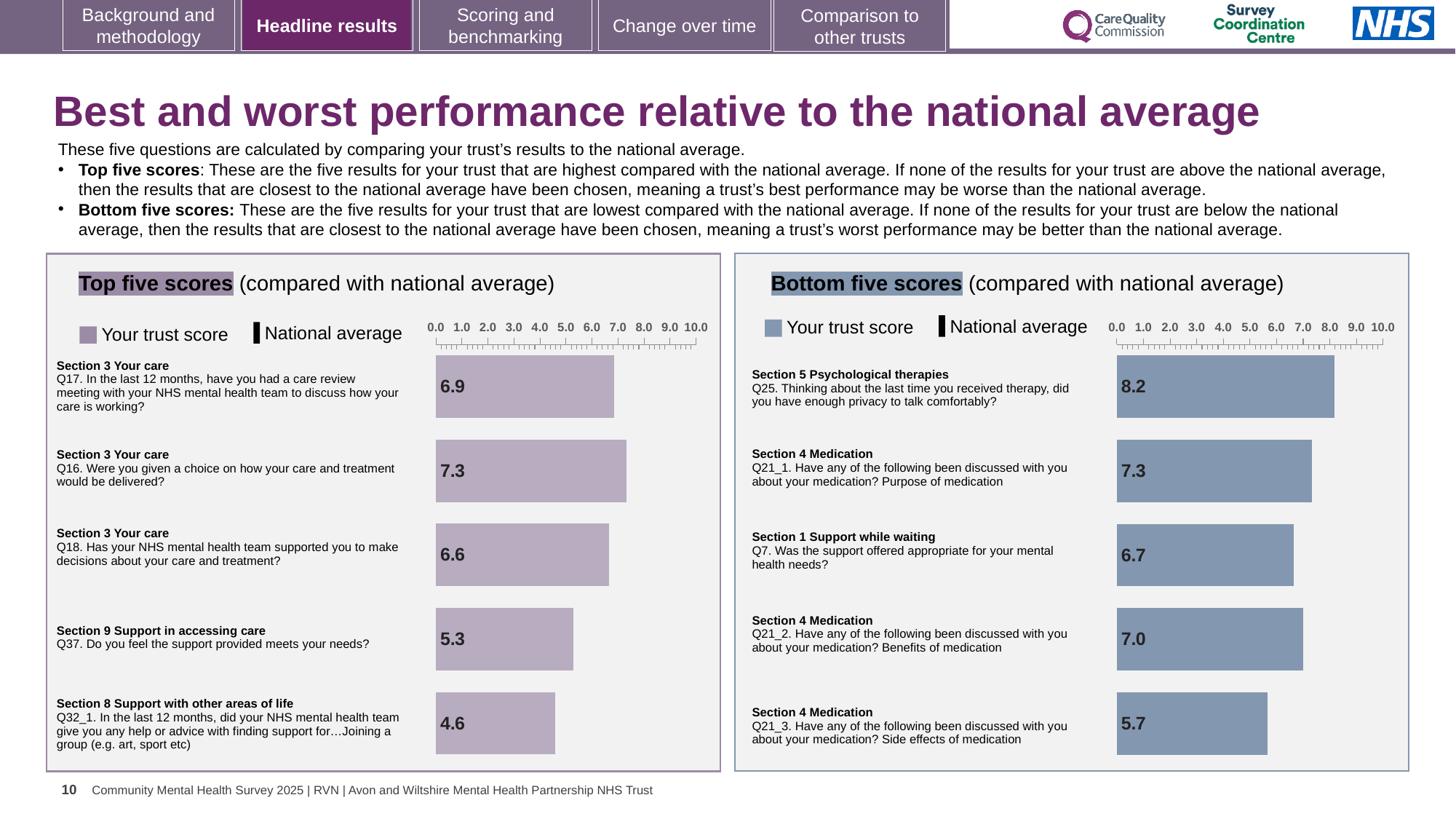
What kind of chart is the Top five scores chart? Bar chart In the Top five scores chart, which question has the highest trust score? Q16 In the Bottom five scores chart, which question has the highest trust score? Q25 In the Bottom five scores chart, which question has the lowest trust score? Q21_3 In the Top five scores chart, what is the difference between the trust scores for Q17 and Q37? 1.6 In the Top five scores chart, which has the larger trust score, Q17 or Q18? Q17 In the Bottom five scores chart, what is the difference between the trust scores for Q25 and Q21_3? 2.5 In the Top five scores chart, which question has the lowest trust score? Q32_1 In the Top five scores chart, what is the trust score for Q16 (Were you given a choice on how your care and treatment would be delivered)? 7.3 How many bars are shown in the Bottom five scores chart? 5 How many entries does the legend of the Bottom five scores chart list? 2 In the Bottom five scores chart, what is the trust score for Q25 (did you have enough privacy to talk comfortably)? 8.2